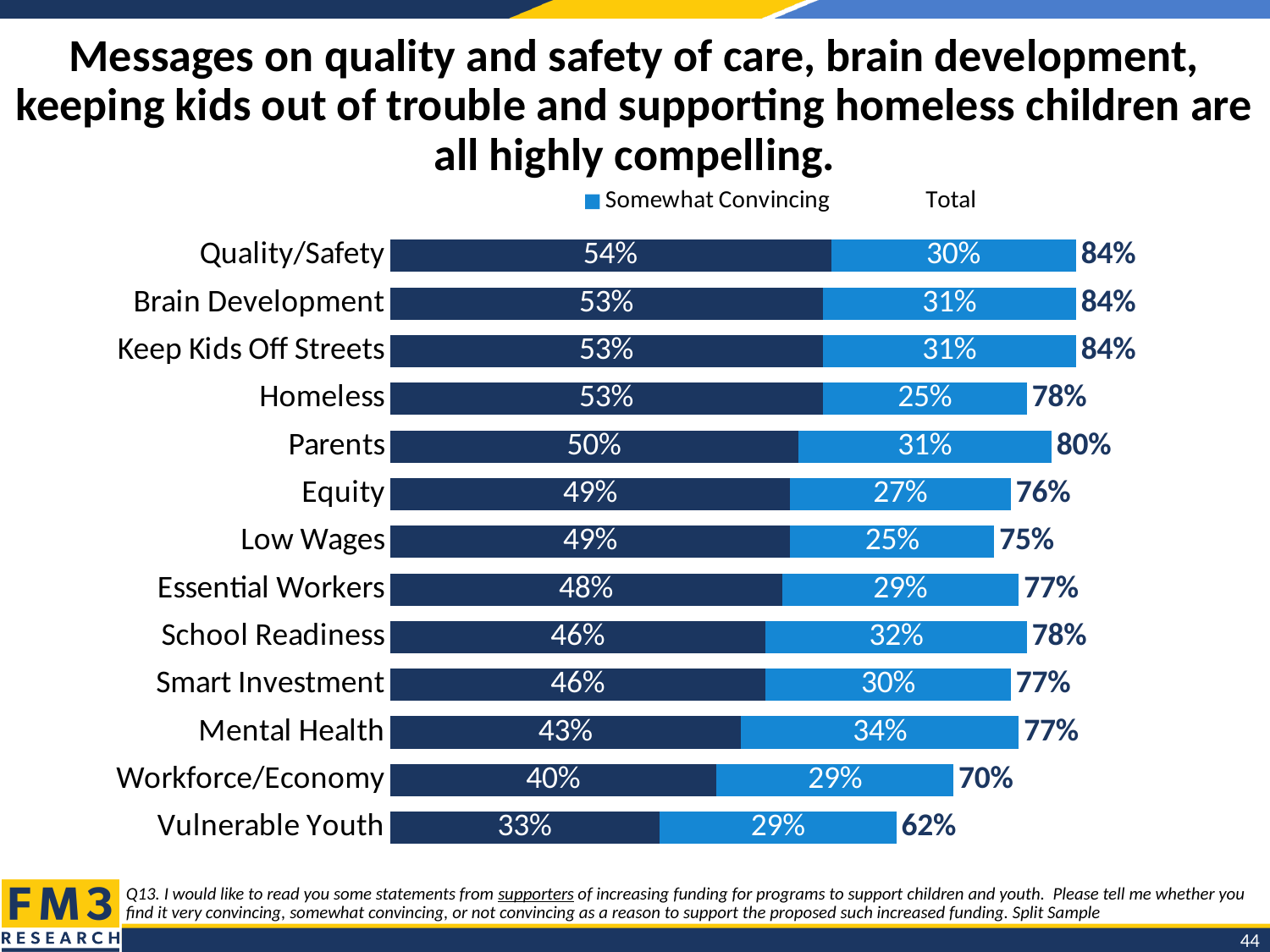
What is the Somewhat Convincing value for Mental Health? 34% What is the Total value for Vulnerable Youth? 62% What is the total of the stacked bar for Homeless? 78% Which has a larger Total value, Parents or Equity? Parents Which category has the highest Somewhat Convincing value? Mental Health What is the value of the dark blue segment for Workforce/Economy? 40% What is the difference between the Total values for Quality/Safety and Workforce/Economy? 14% What is the difference between the Somewhat Convincing values for School Readiness and Low Wages? 7% What is the Total value for Quality/Safety? 84% Which category has the lowest Total value? Vulnerable Youth What kind of chart is shown on the slide? Bar chart How many categories are shown in the chart? 13